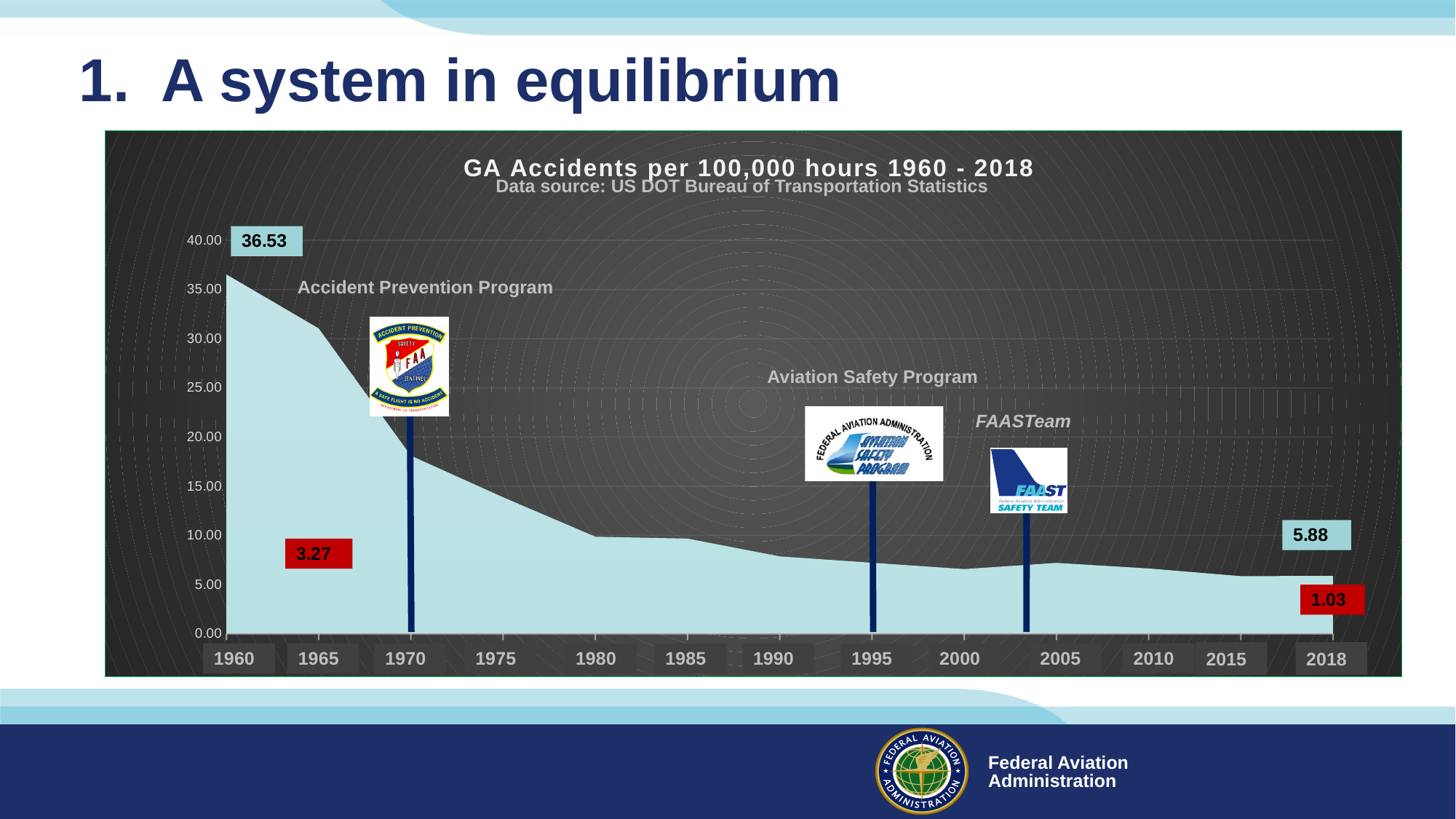
What is the difference between the labelled 1960 value (36.53) and the labelled 2018 value (5.88)? 30.65 What kind of chart is shown on the slide? area chart Do the accident rate values rise or fall from 1960 to 2018? fall Is the accident rate for 1990 greater or less than 10.00? less How many year labels are shown on the x axis? 13 What is the labelled GA accident rate per 100,000 hours at the end of the series in 2018? 5.88 Which is larger, the accident rate in 1960 or in 2018? 1960 What is the title of the chart? GA Accidents per 100,000 hours 1960 - 2018 Which year has the highest accident rate on the chart? 1960 Is the accident rate for 1970 greater or less than 15.00? greater What is the labelled GA accident rate per 100,000 hours at the start of the series in 1960? 36.53